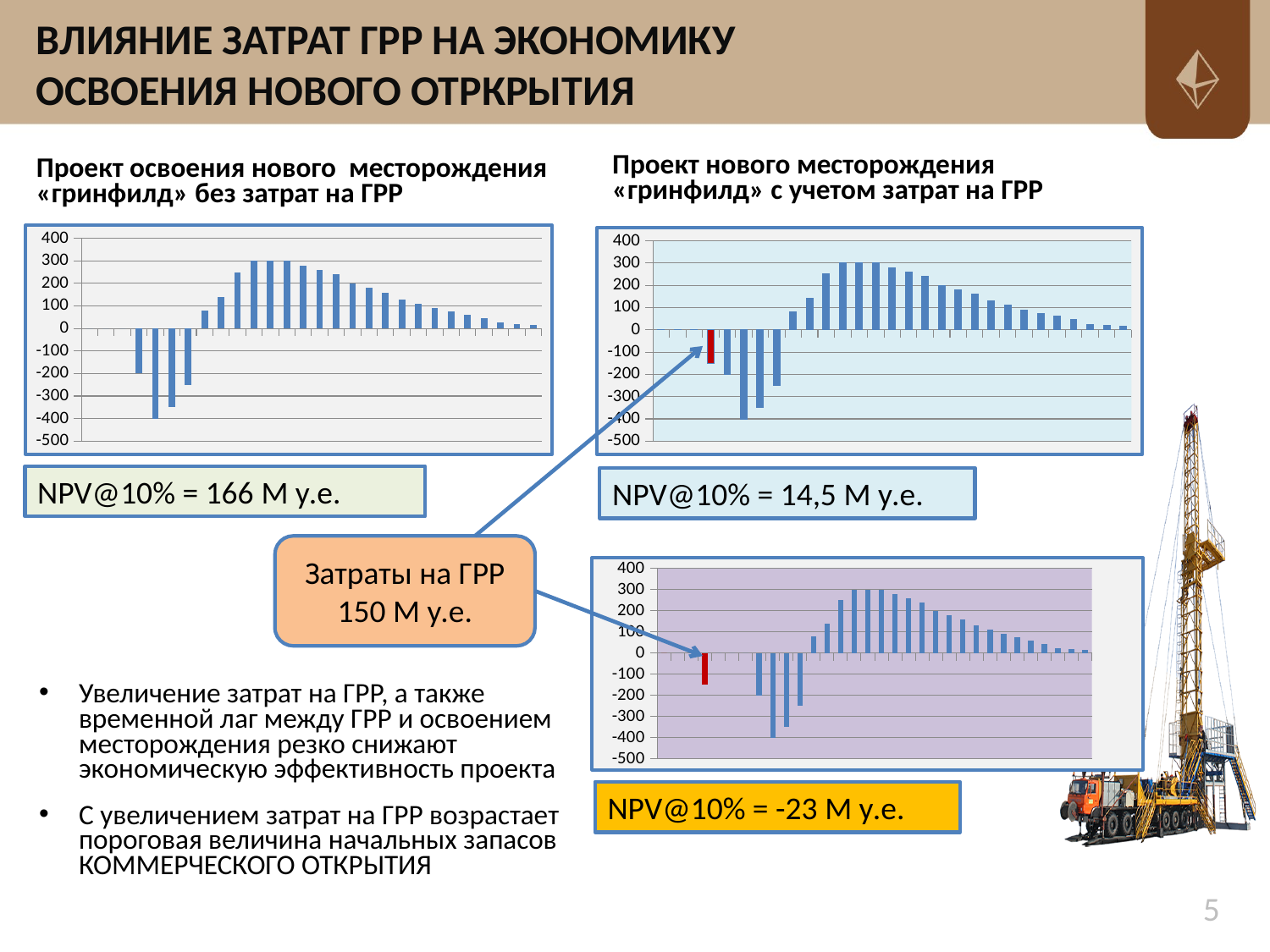
In the top-left chart, do the positive bars rise or fall from the tallest bar toward the right end of the axis? fall In the top-right chart, is the red bar greater or less than -100? less In the top-right chart, which extends further below zero: the red bar or the lowest blue bar? the lowest blue bar In the top-right chart, what colour is the single bar that differs from the others? red In the top-left chart, is the lowest bar greater or less than -300? less What kind of chart is the top-left chart on the slide? bar chart In the top-left chart, is the tallest bar greater or less than 200? greater What kind of chart is the bottom-right chart on the slide? bar chart How many charts are shown on the slide? 3